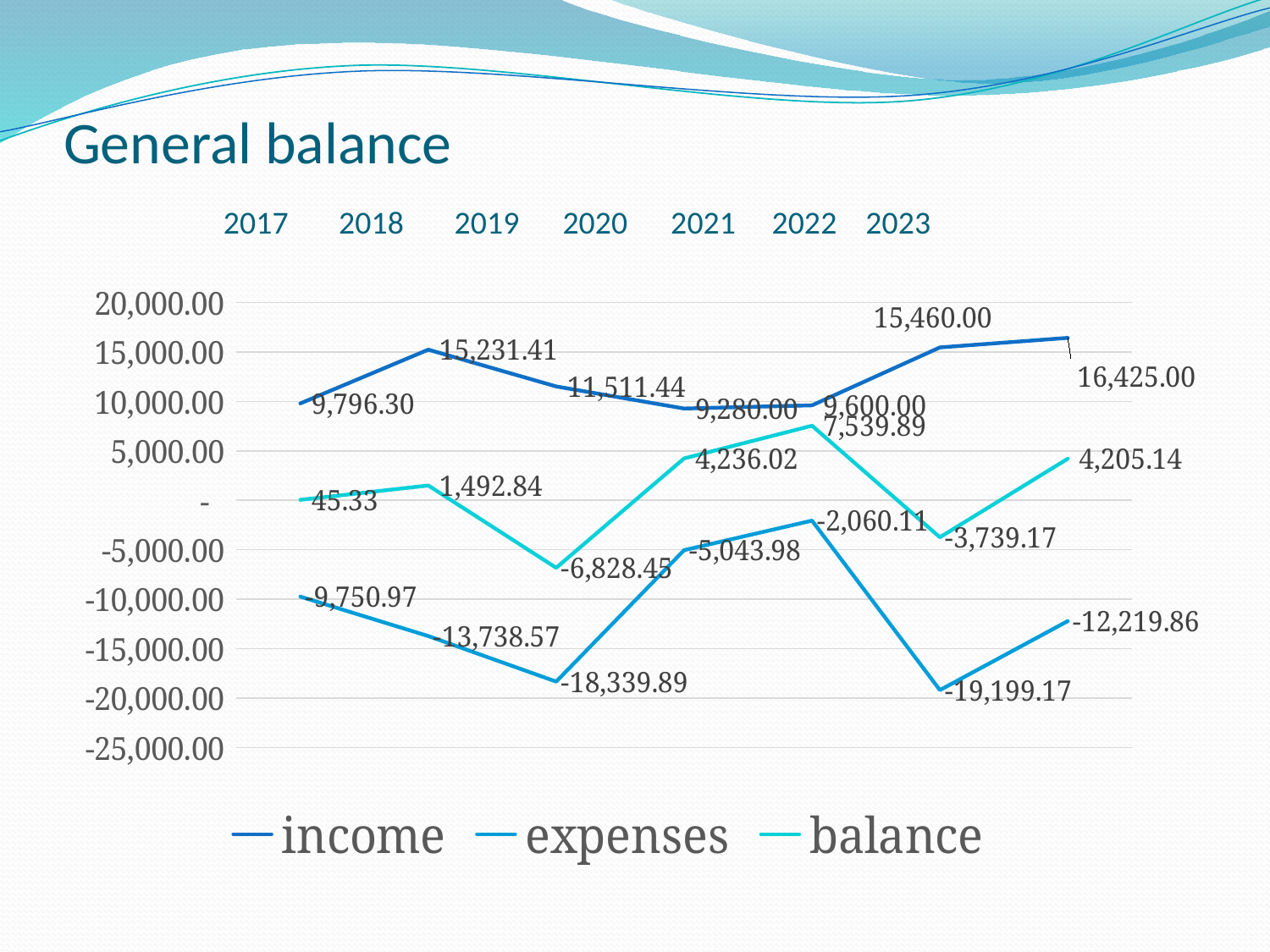
What is the title of the slide? General balance What is the income value for 2018? 15,231.41 In which year is the balance lowest? 2019 What type of chart is shown on the slide? line chart What is the expenses value for 2022? -19,199.17 In which year is income highest? 2023 How many years are plotted along the x axis? 7 Which is larger, the balance in 2020 or the balance in 2023? 2020 How many series does the legend list? 3 What is the balance value for 2021? 7,539.89 What is the difference between income in 2023 and income in 2022? 965.00 Does income rise or fall from 2020 to 2023? rise